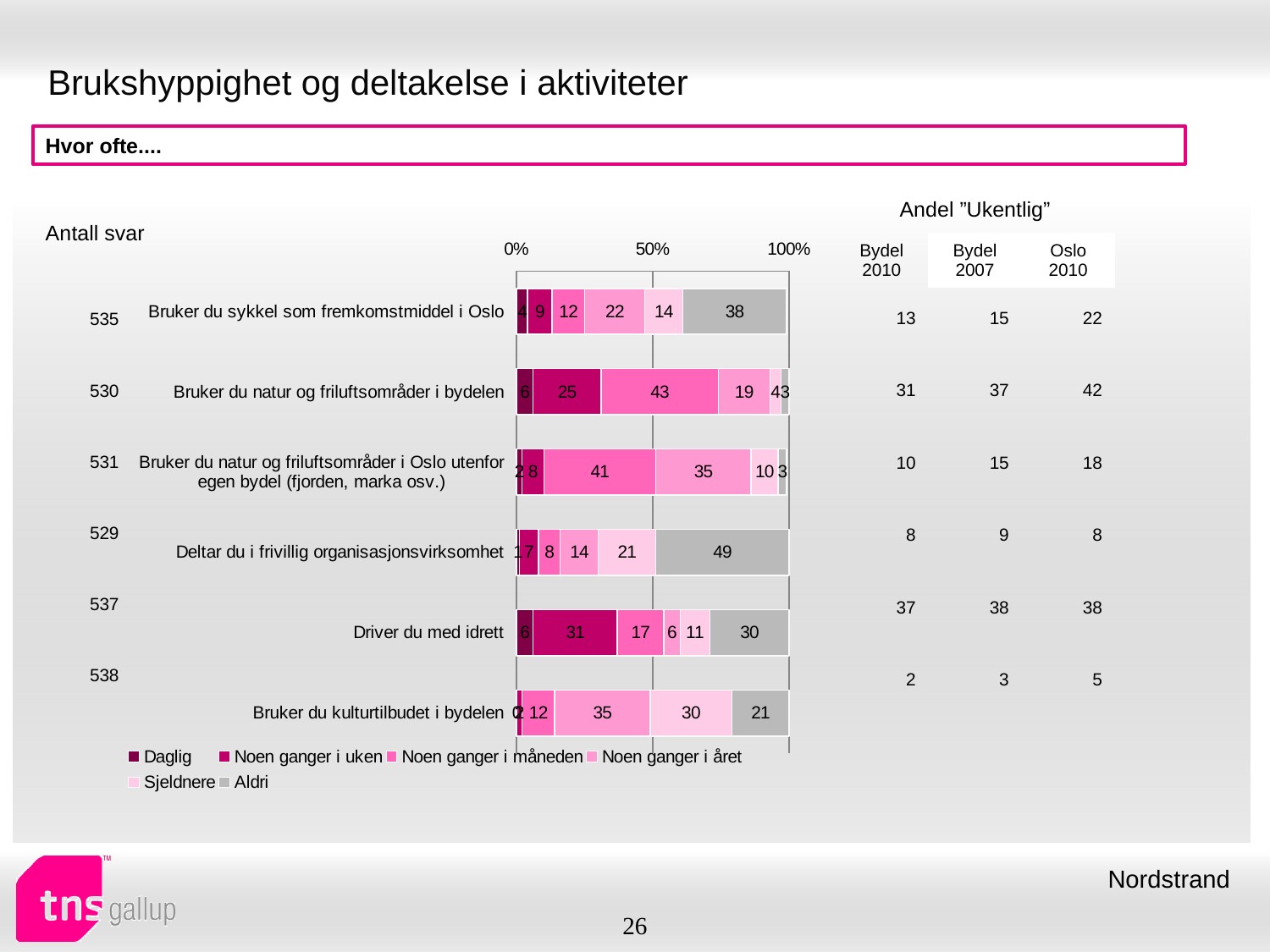
What is the first entry in the chart's legend? Daglig Which has a larger 'Aldri' value: 'Bruker du sykkel som fremkomstmiddel i Oslo' or 'Driver du med idrett'? Bruker du sykkel som fremkomstmiddel i Oslo What is the difference between the 'Aldri' values for 'Deltar du i frivillig organisasjonsvirksomhet' and 'Bruker du kulturtilbudet i bydelen'? 28 How many activity categories are plotted in the bar chart? 6 What is the value of the 'Aldri' segment for 'Deltar du i frivillig organisasjonsvirksomhet'? 49 What is the value of the 'Noen ganger i uken' segment for 'Driver du med idrett'? 31 What is the value of the 'Noen ganger i måneden' segment for 'Bruker du natur og friluftsområder i Oslo utenfor egen bydel (fjorden, marka osv.)'? 41 What is the value of the 'Noen ganger i måneden' segment for 'Bruker du natur og friluftsområder i bydelen'? 43 What is the value of the 'Aldri' segment for 'Bruker du sykkel som fremkomstmiddel i Oslo'? 38 Which category has the largest 'Aldri' segment? Deltar du i frivillig organisasjonsvirksomhet What kind of chart is shown on the slide? Stacked bar chart How many series does the legend of the bar chart list? 6